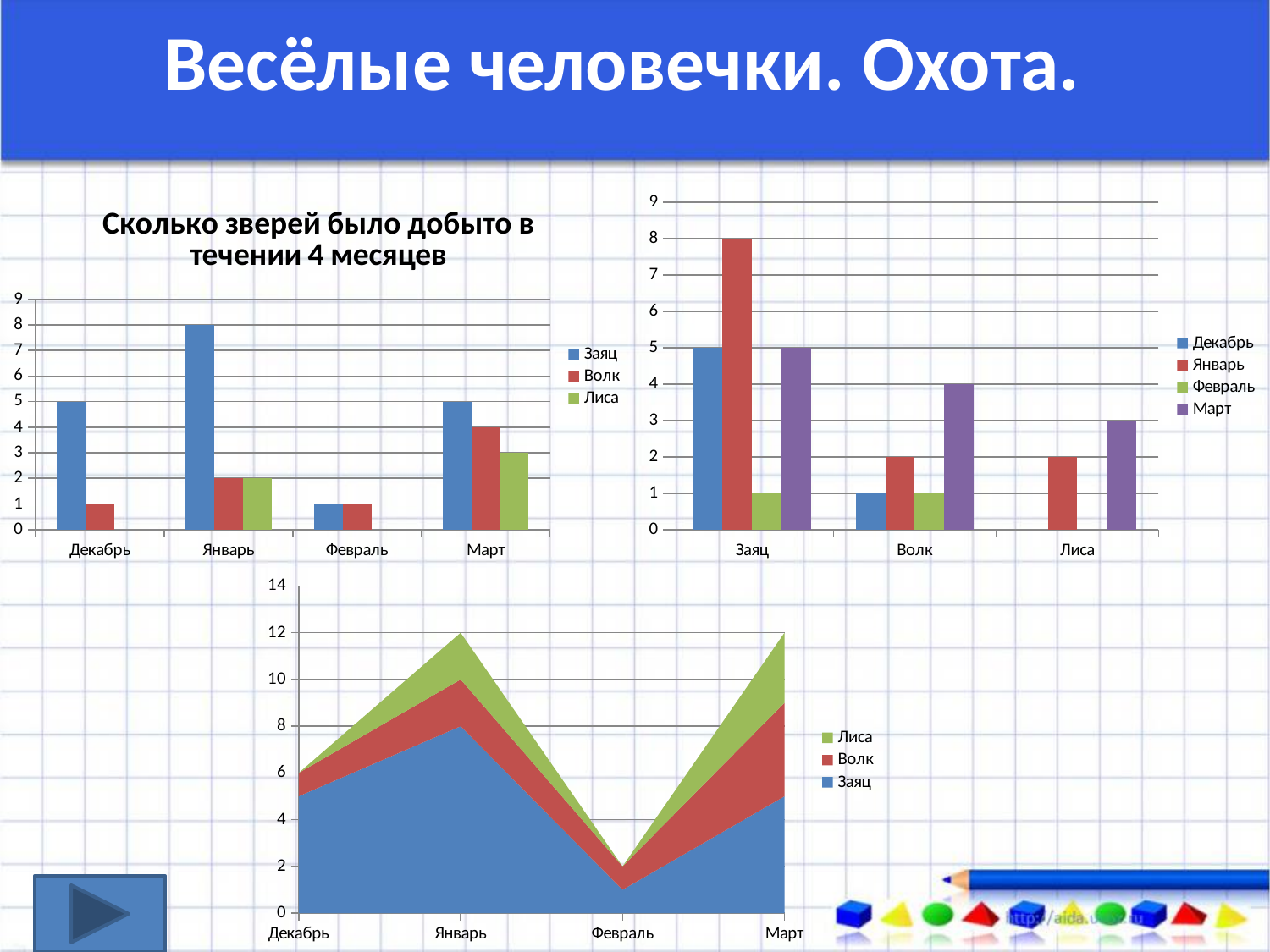
In the top-right bar chart, what is the difference between the Январь and Декабрь values for Заяц? 3 In the top-left chart titled 'Сколько зверей было добыто в течении 4 месяцев', what is the value for Заяц in Январь? 8 In the bottom stacked area chart, what is the total of all series in Январь? 12 In the top-right bar chart, what is the value for Март for Волк? 4 In the top-right bar chart, how many series does the legend list? 4 In the top-left chart titled 'Сколько зверей было добыто в течении 4 месяцев', how many series does the legend list? 3 In the top-left chart titled 'Сколько зверей было добыто в течении 4 месяцев', in which month is the Заяц value highest? Январь In the top-right bar chart, which is larger for Лиса: the Январь value or the Март value? Март In the top-right bar chart, which month has the highest value for Заяц? Январь In the top-left chart titled 'Сколько зверей было добыто в течении 4 месяцев', how many months are shown on the x axis? 4 What kind of chart is the bottom chart on the slide? Stacked area chart In the top-left chart titled 'Сколько зверей было добыто в течении 4 месяцев', what is the value for Волк in Март? 4